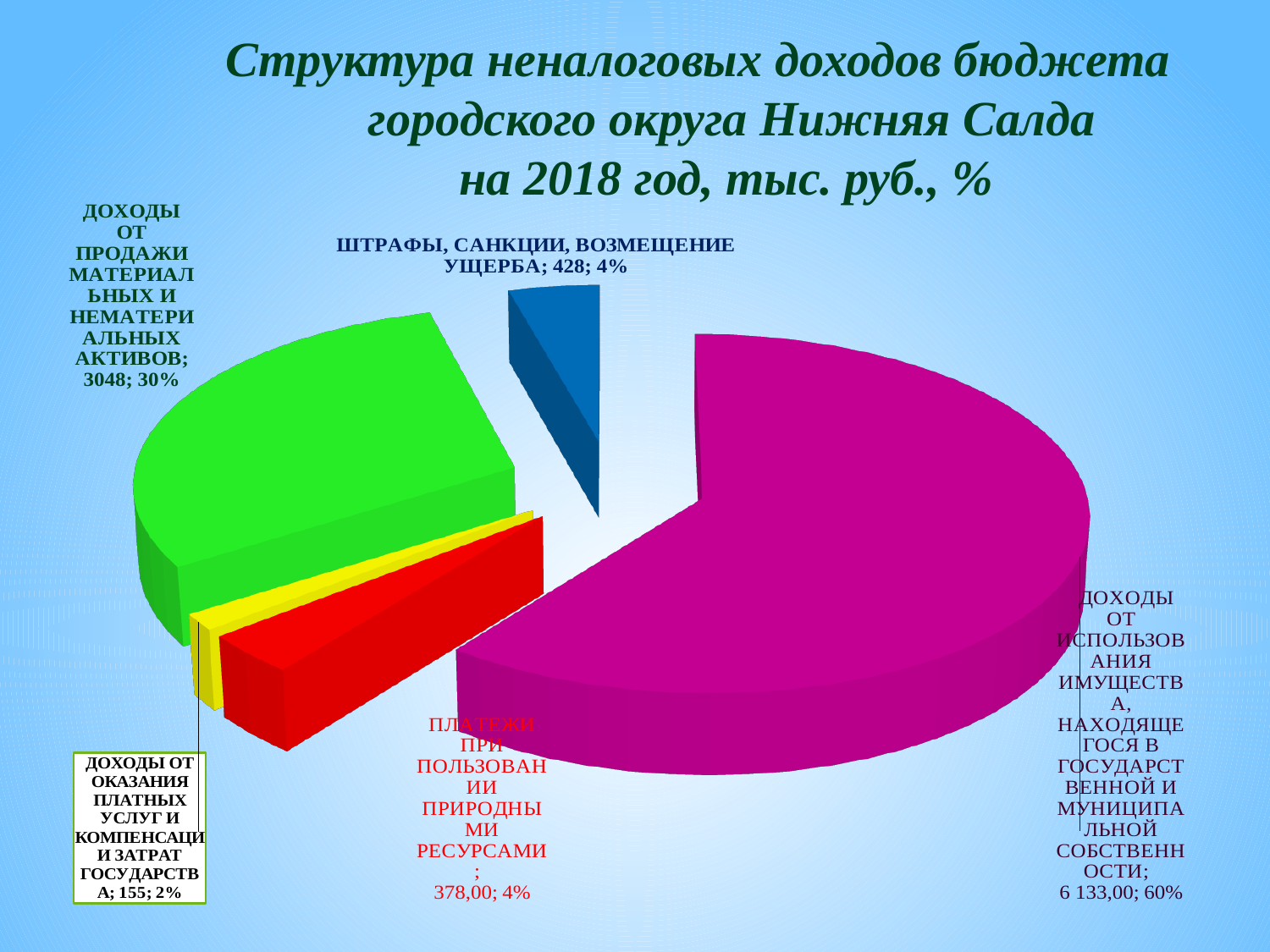
How many slices does the pie chart have? 5 What is the value shown for ДОХОДЫ ОТ ПРОДАЖИ МАТЕРИАЛЬНЫХ И НЕМАТЕРИАЛЬНЫХ АКТИВОВ? 3048 What is the value shown for ДОХОДЫ ОТ ИСПОЛЬЗОВАНИЯ ИМУЩЕСТВА, НАХОДЯЩЕГОСЯ В ГОСУДАРСТВЕННОЙ И МУНИЦИПАЛЬНОЙ СОБСТВЕННОСТИ? 6 133,00 Which category has the largest share of the pie? ДОХОДЫ ОТ ИСПОЛЬЗОВАНИЯ ИМУЩЕСТВА, НАХОДЯЩЕГОСЯ В ГОСУДАРСТВЕННОЙ И МУНИЦИПАЛЬНОЙ СОБСТВЕННОСТИ Which category has the smallest share of the pie? ДОХОДЫ ОТ ОКАЗАНИЯ ПЛАТНЫХ УСЛУГ И КОМПЕНСАЦИИ ЗАТРАТ ГОСУДАРСТВА What is the value shown for ШТРАФЫ, САНКЦИИ, ВОЗМЕЩЕНИЕ УЩЕРБА? 428 What percentage share of the pie does ДОХОДЫ ОТ ПРОДАЖИ МАТЕРИАЛЬНЫХ И НЕМАТЕРИАЛЬНЫХ АКТИВОВ have? 30% What percentage share of the pie does ДОХОДЫ ОТ ОКАЗАНИЯ ПЛАТНЫХ УСЛУГ И КОМПЕНСАЦИИ ЗАТРАТ ГОСУДАРСТВА have? 2% What type of chart is shown on the slide? Pie chart What is the difference between the values for ДОХОДЫ ОТ ПРОДАЖИ МАТЕРИАЛЬНЫХ И НЕМАТЕРИАЛЬНЫХ АКТИВОВ and ШТРАФЫ, САНКЦИИ, ВОЗМЕЩЕНИЕ УЩЕРБА? 2620 What is the value shown for ПЛАТЕЖИ ПРИ ПОЛЬЗОВАНИИ ПРИРОДНЫМИ РЕСУРСАМИ? 378,00 Which is larger: the value for ШТРАФЫ, САНКЦИИ, ВОЗМЕЩЕНИЕ УЩЕРБА or the value for ПЛАТЕЖИ ПРИ ПОЛЬЗОВАНИИ ПРИРОДНЫМИ РЕСУРСАМИ? ШТРАФЫ, САНКЦИИ, ВОЗМЕЩЕНИЕ УЩЕРБА